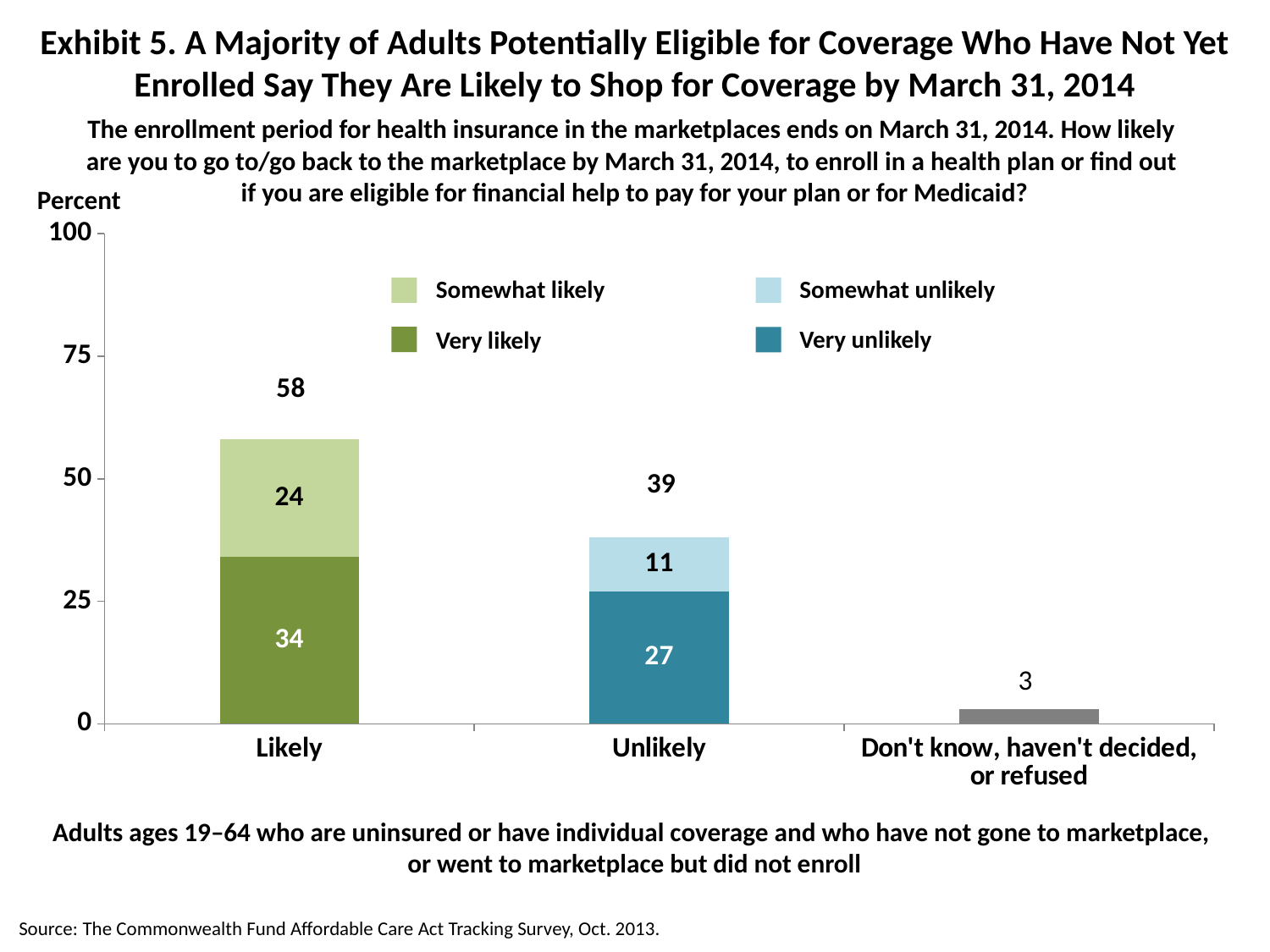
What is the value for Very unlikely within the Unlikely bar? 27 Which category has the lowest value? Don't know, haven't decided, or refused How many series does the legend list? 4 What is the value for Somewhat unlikely within the Unlikely bar? 11 Which category has the highest total value? Likely What kind of chart is shown on the slide? Stacked bar chart What is the value for Very likely within the Likely bar? 34 What is the value for the Don't know, haven't decided, or refused category? 3 Which is larger: the Very likely value or the Somewhat likely value? Very likely How many categories are shown on the x axis? 3 What is the difference between the Likely total (58) and the Unlikely total (39)? 19 What is the total value shown for the Likely bar? 58